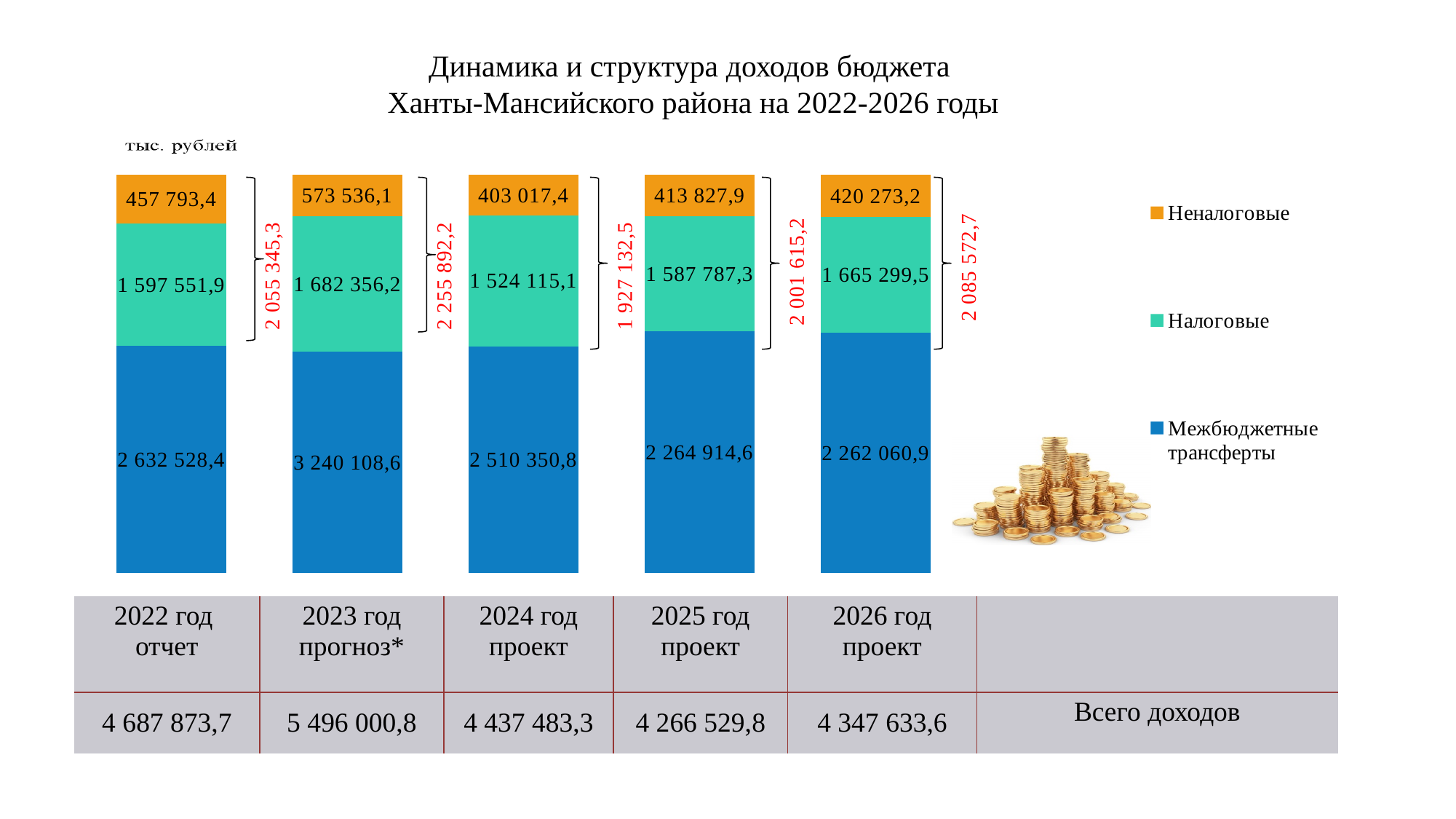
By how much does Налоговые in 2023 exceed Налоговые in 2022? 84 804,3 Which is larger: Неналоговые in 2025 or Неналоговые in 2026? 2026 How many years (bars) are shown in the chart? 5 Which year has the highest value for Межбюджетные трансферты? 2023 год прогноз* What is the value of Неналоговые for 2026 год проект? 420 273,2 Do the values for Межбюджетные трансферты rise or fall from 2023 to 2026? Fall Which year has the lowest value for Неналоговые? 2024 год проект How many series does the legend list? 3 What kind of chart is shown on the slide? Stacked bar chart What is the value of Налоговые for 2024 год проект? 1 524 115,1 What is the total income (Всего доходов) for 2022 год отчет? 4 687 873,7 What is the value of Межбюджетные трансферты for 2023 год прогноз*? 3 240 108,6